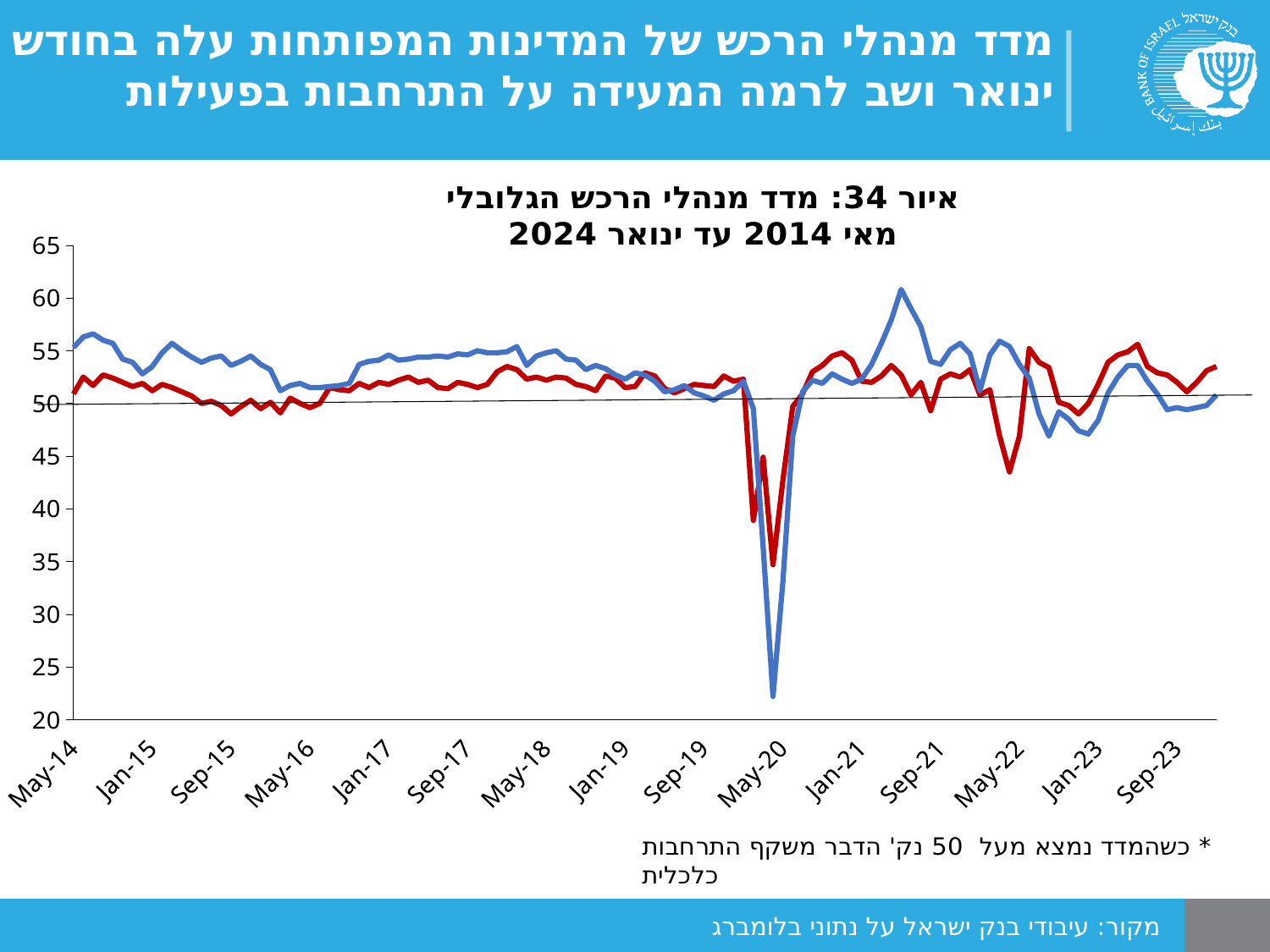
How many date labels are shown on the x axis? 15 Near which x-axis label does the blue line reach its lowest value? May-20 What kind of chart is shown on the slide? line chart How many lines are plotted on the chart? 2 Is the value of the blue line at Jan-23 greater or less than 50? less What is the range of the y axis, from its lowest to its highest tick? 20 to 65 Is the value of the red line at May-22 greater or less than 50? less At May-20, which line has the lower value, the blue line or the red line? the blue line At Sep-21, which line has the higher value, the blue line or the red line? the blue line